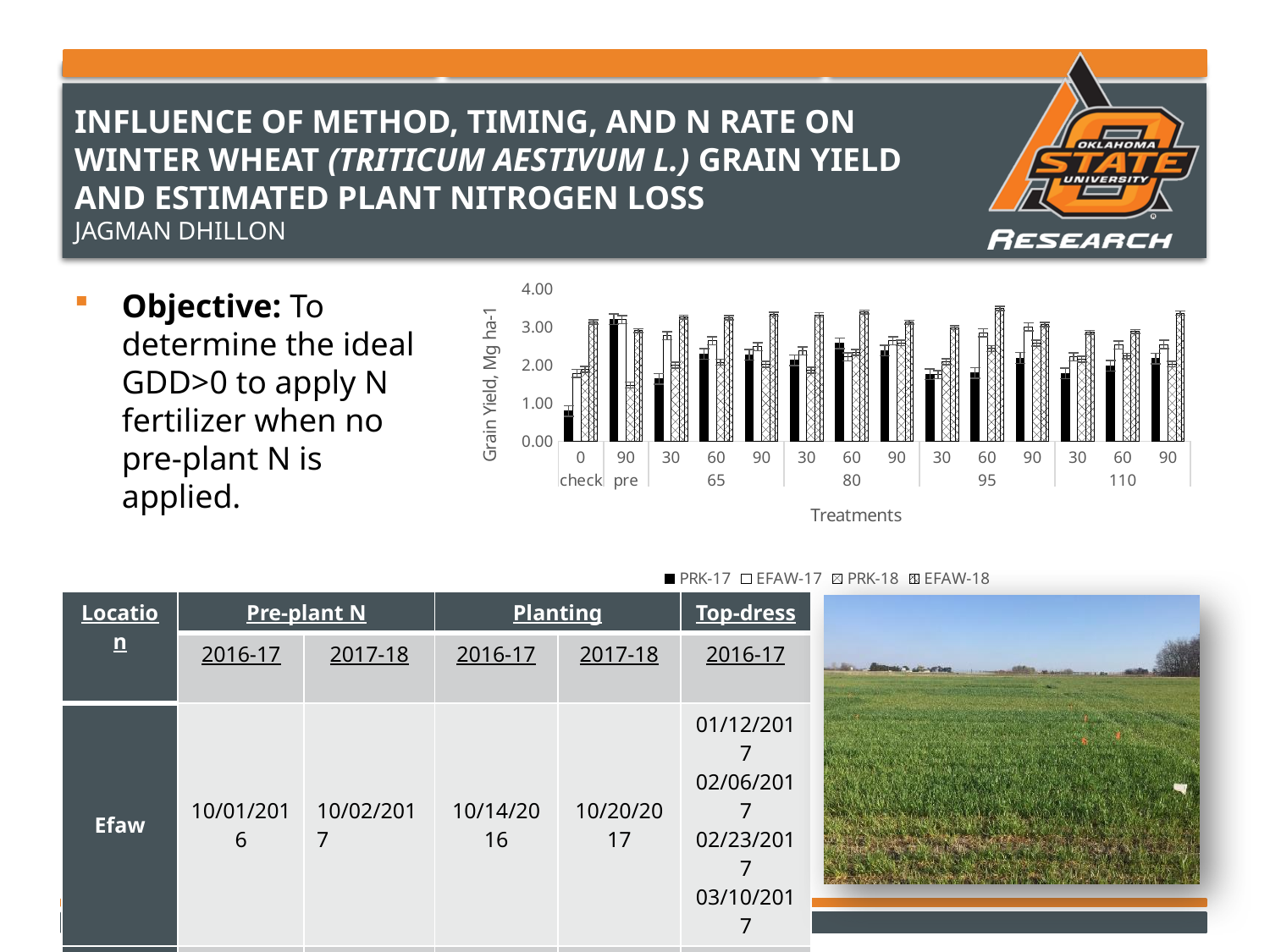
What are the series names listed in the chart legend? PRK-17, EFAW-17, PRK-18, EFAW-18 What is the label of the chart's vertical axis? Grain Yield, Mg ha-1 For the PRK-17 series, which treatment has the lowest grain yield? 0 check Is the PRK-18 value for the 90 pre treatment greater or less than 2.00? less What kind of chart is shown on the slide? bar chart For the PRK-17 series, which is larger: the value for 0 check or the value for 90 pre? 90 pre How many series does the chart legend list? 4 Is the EFAW-18 value for the 60 treatment in the 95 group greater or less than 3.00? greater Is the PRK-17 value for the 0 check treatment greater or less than 1.00? less How many treatment categories are plotted along the x axis of the chart? 14